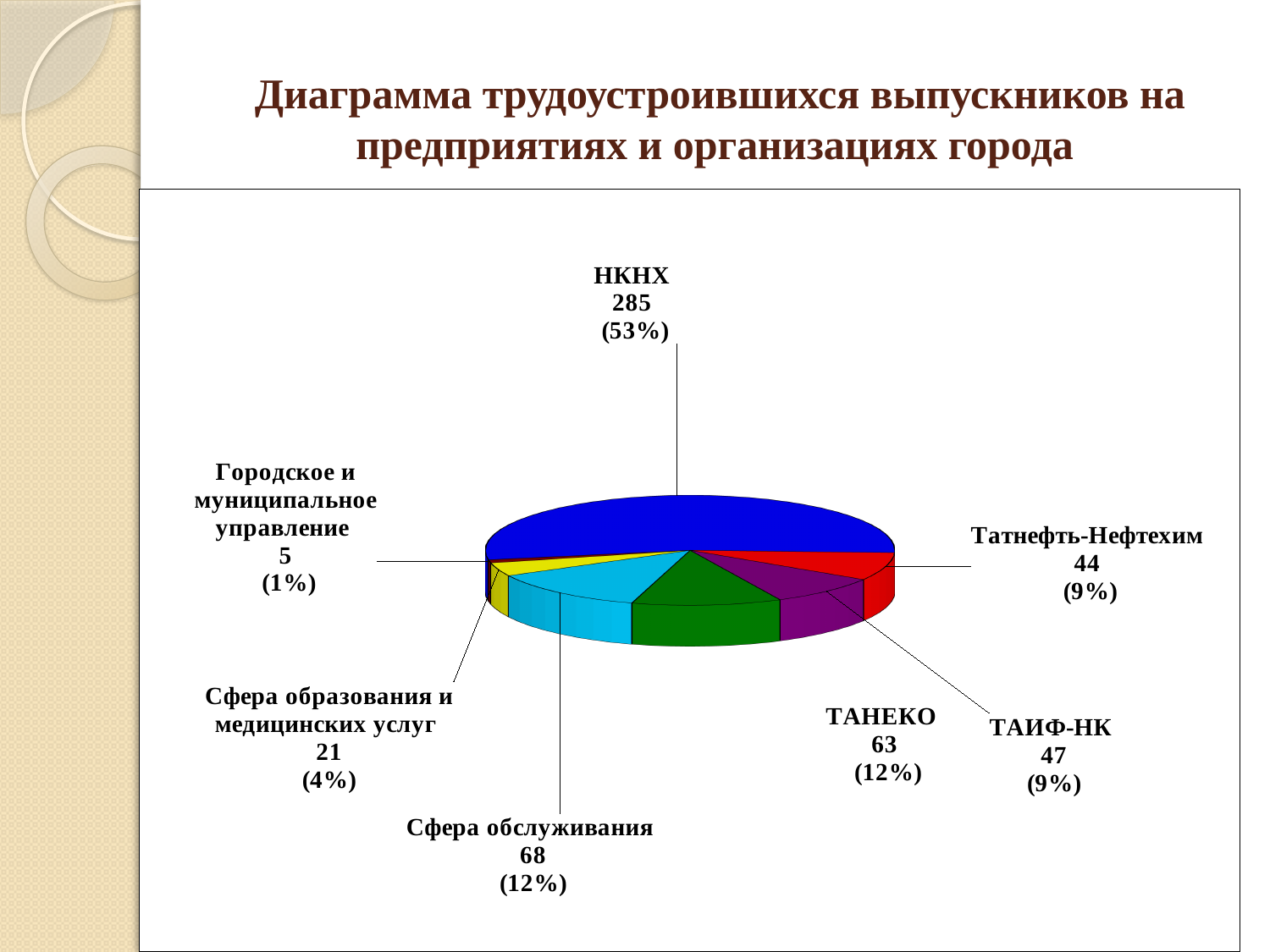
What is the value for НКНХ? 285 What is the value for Сфера обслуживания? 68 What kind of chart is shown on the slide? pie chart What is the value for Городское и муниципальное управление? 5 Which category has the largest slice? НКНХ What is the title of the slide? Диаграмма трудоустроившихся выпускников на предприятиях и организациях города Which category has the smallest slice? Городское и муниципальное управление Which is larger, the value for Сфера обслуживания or the value for ТАНЕКО? Сфера обслуживания What share of the pie does НКНХ represent? 53% How many slices does the pie chart have? 7 What is the difference between the values for ТАИФ-НК and Татнефть-Нефтехим? 3 What share of the pie does Сфера образования и медицинских услуг represent? 4%